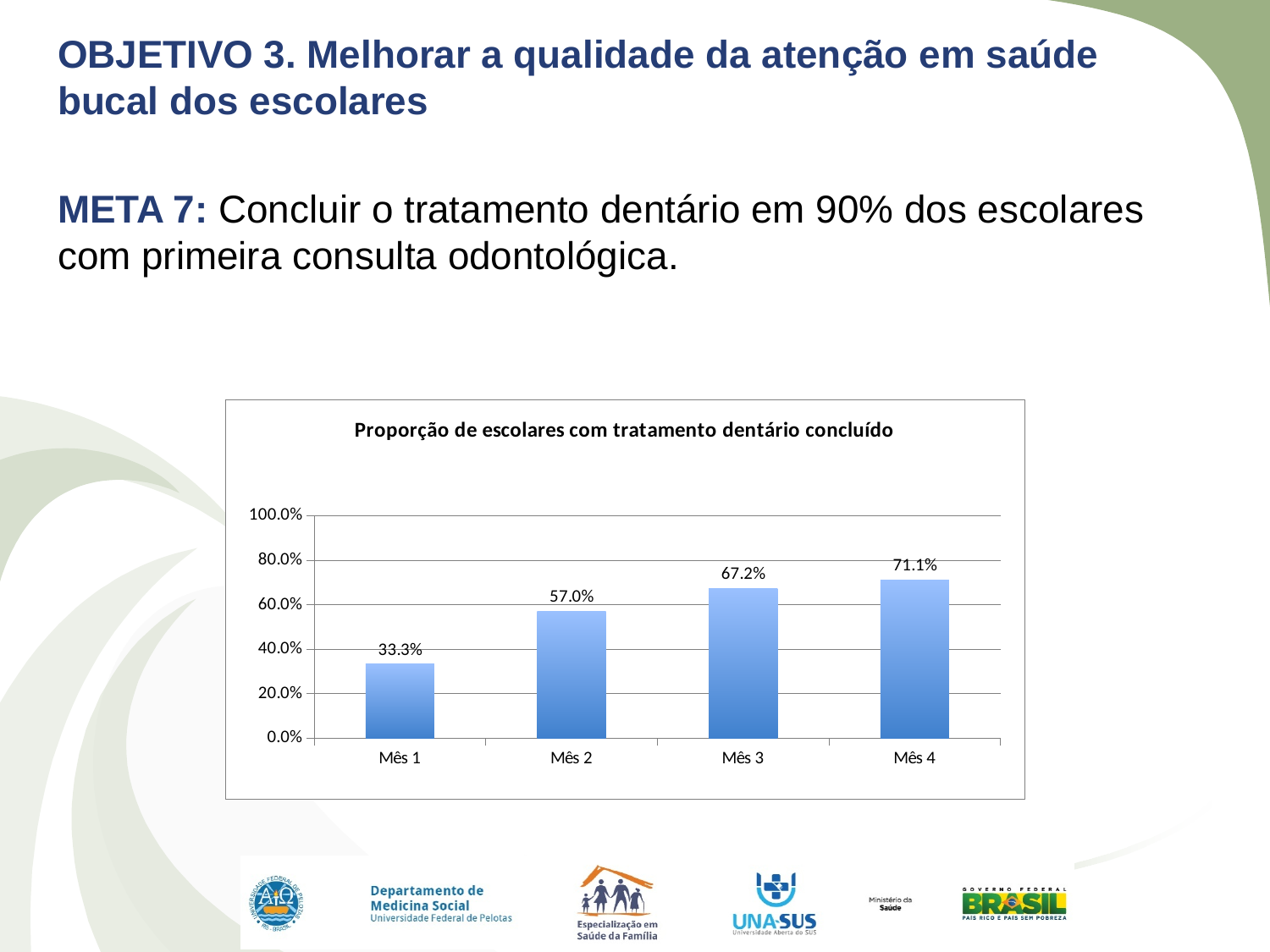
Which is larger, the value for Mês 2 or the value for Mês 3? Mês 3 What is the value for Mês 1? 33.3% How many months are shown on the x axis? 4 Which month has the lowest proportion of students with completed dental treatment? Mês 1 What is the value for Mês 2? 57.0% Which month has the highest proportion of students with completed dental treatment? Mês 4 What is the difference between the values for Mês 4 and Mês 1? 37.8% What is the value for Mês 3? 67.2% What is the value for Mês 4? 71.1% What kind of chart is shown on the slide? bar chart Is the value for Mês 4 greater or less than 80.0%? less What is the difference between the values for Mês 2 and Mês 1? 23.7%